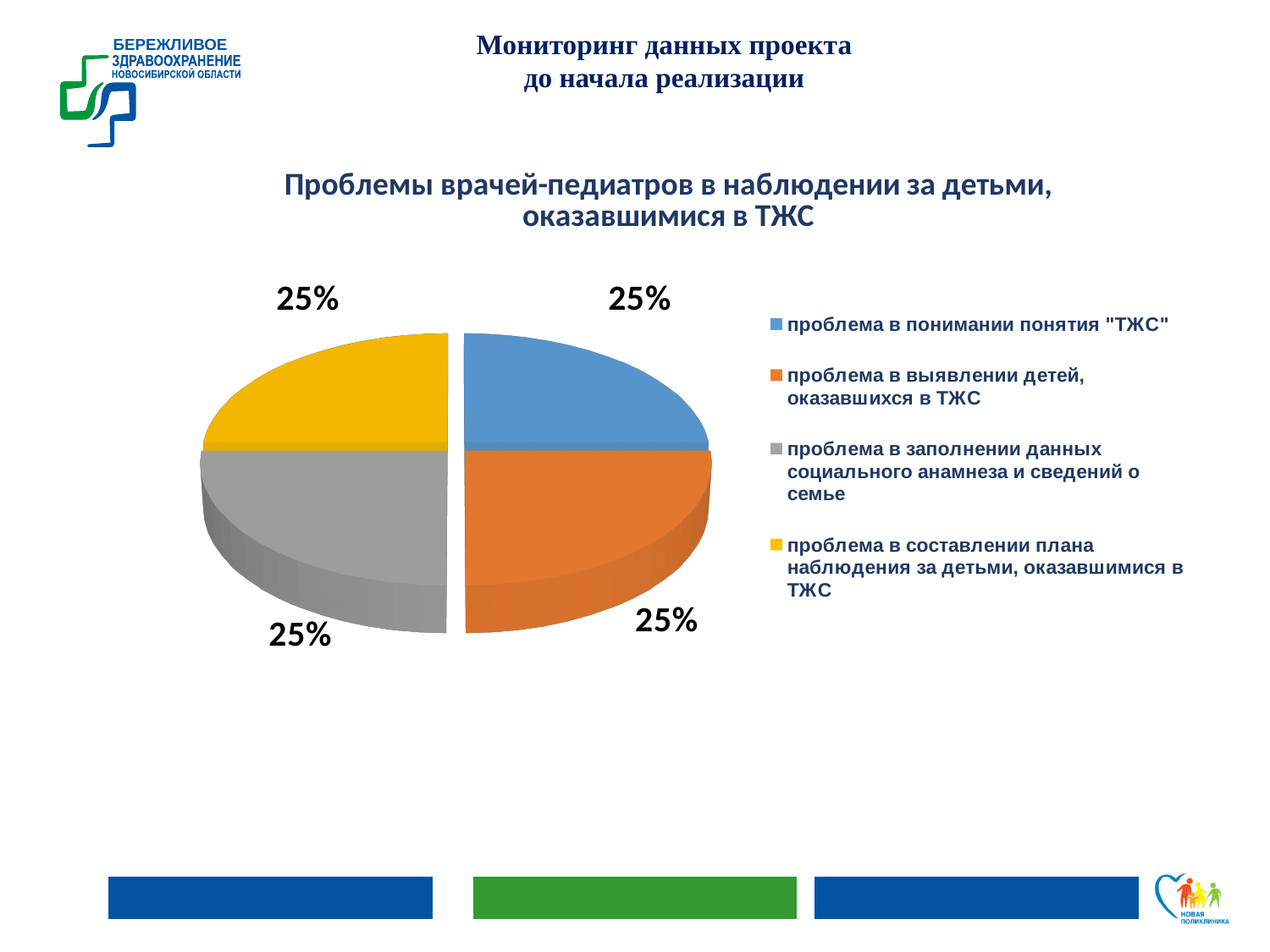
What share of the pie does the slice "проблема в составлении плана наблюдения за детьми, оказавшимися в ТЖС" take? 25% What is the title of the pie chart? Проблемы врачей-педиатров в наблюдении за детьми, оказавшимися в ТЖС Is the share for "проблема в заполнении данных социального анамнеза и сведений о семье" greater or less than 50%? less What is the combined share of the slices "проблема в понимании понятия "ТЖС"" and "проблема в составлении плана наблюдения за детьми, оказавшимися в ТЖС"? 50% Which colour represents "проблема в составлении плана наблюдения за детьми, оказавшимися в ТЖС" in the pie chart? yellow What share of the pie does the slice "проблема в заполнении данных социального анамнеза и сведений о семье" take? 25% What is the difference between the share for "проблема в понимании понятия "ТЖС"" and the share for "проблема в выявлении детей, оказавшихся в ТЖС"? 0% How many slices does the pie chart have? 4 How many entries does the legend of the pie chart list? 4 What share of the pie does the slice "проблема в понимании понятия "ТЖС"" take? 25% What kind of chart is shown on the slide? pie chart